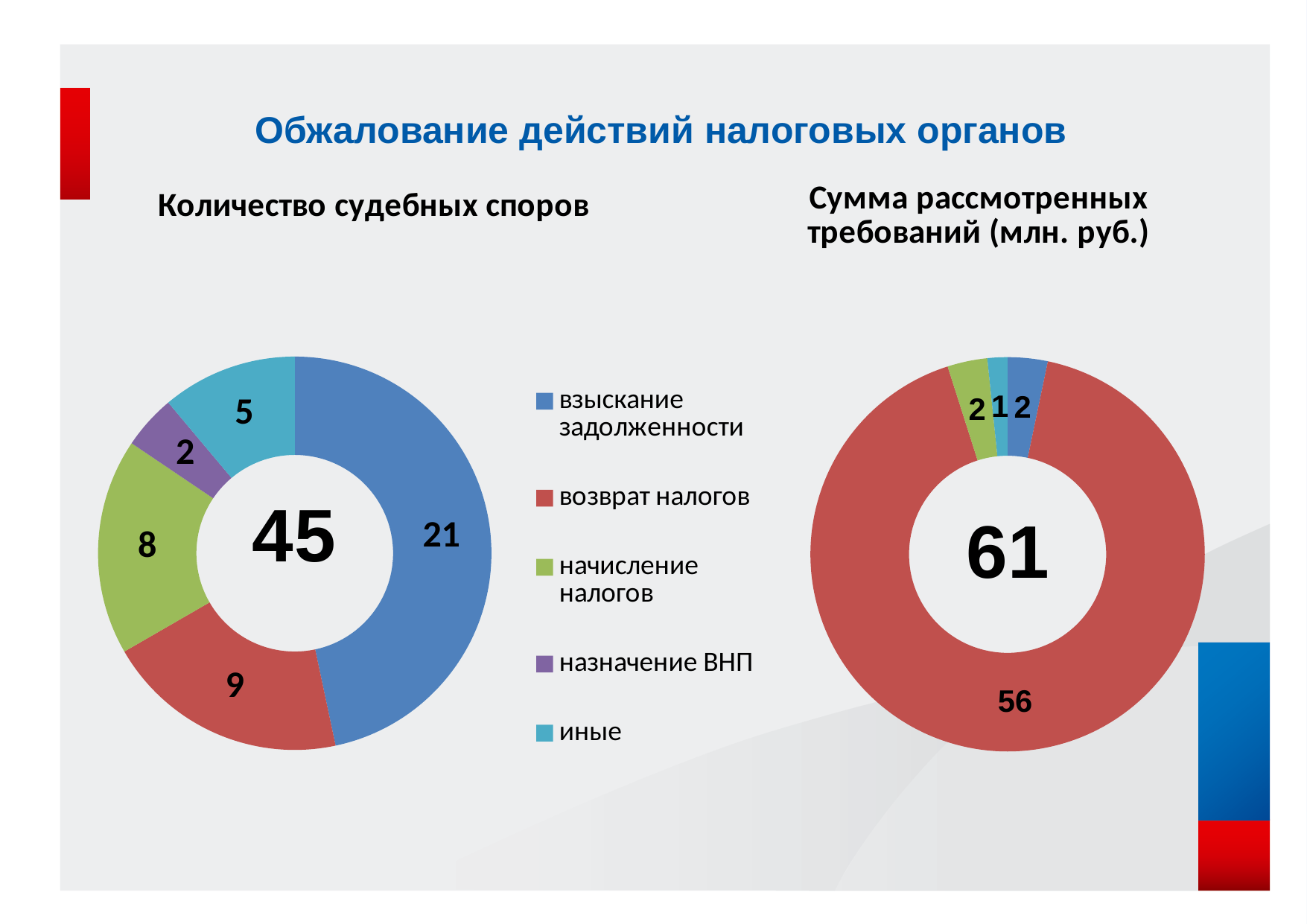
In the chart 'Сумма рассмотренных требований (млн. руб.)', what is the value for 'иные'? 1 In the chart 'Количество судебных споров', which category has the highest value? взыскание задолженности What type of chart is used for 'Количество судебных споров'? doughnut chart In the chart 'Сумма рассмотренных требований (млн. руб.)', which category has the highest value? возврат налогов In the chart 'Количество судебных споров', what is the value for 'возврат налогов'? 9 In the chart 'Сумма рассмотренных требований (млн. руб.)', what is the total shown in the centre of the doughnut? 61 How many entries does the shared legend between the two charts list? 5 In the chart 'Сумма рассмотренных требований (млн. руб.)', what is the value for 'возврат налогов'? 56 In the chart 'Количество судебных споров', what is the value for 'взыскание задолженности'? 21 In the chart 'Количество судебных споров', which category has the lowest value? назначение ВНП In the chart 'Количество судебных споров', what is the total shown in the centre of the doughnut? 45 In the chart 'Количество судебных споров', what is the difference between the values for 'взыскание задолженности' and 'возврат налогов'? 12